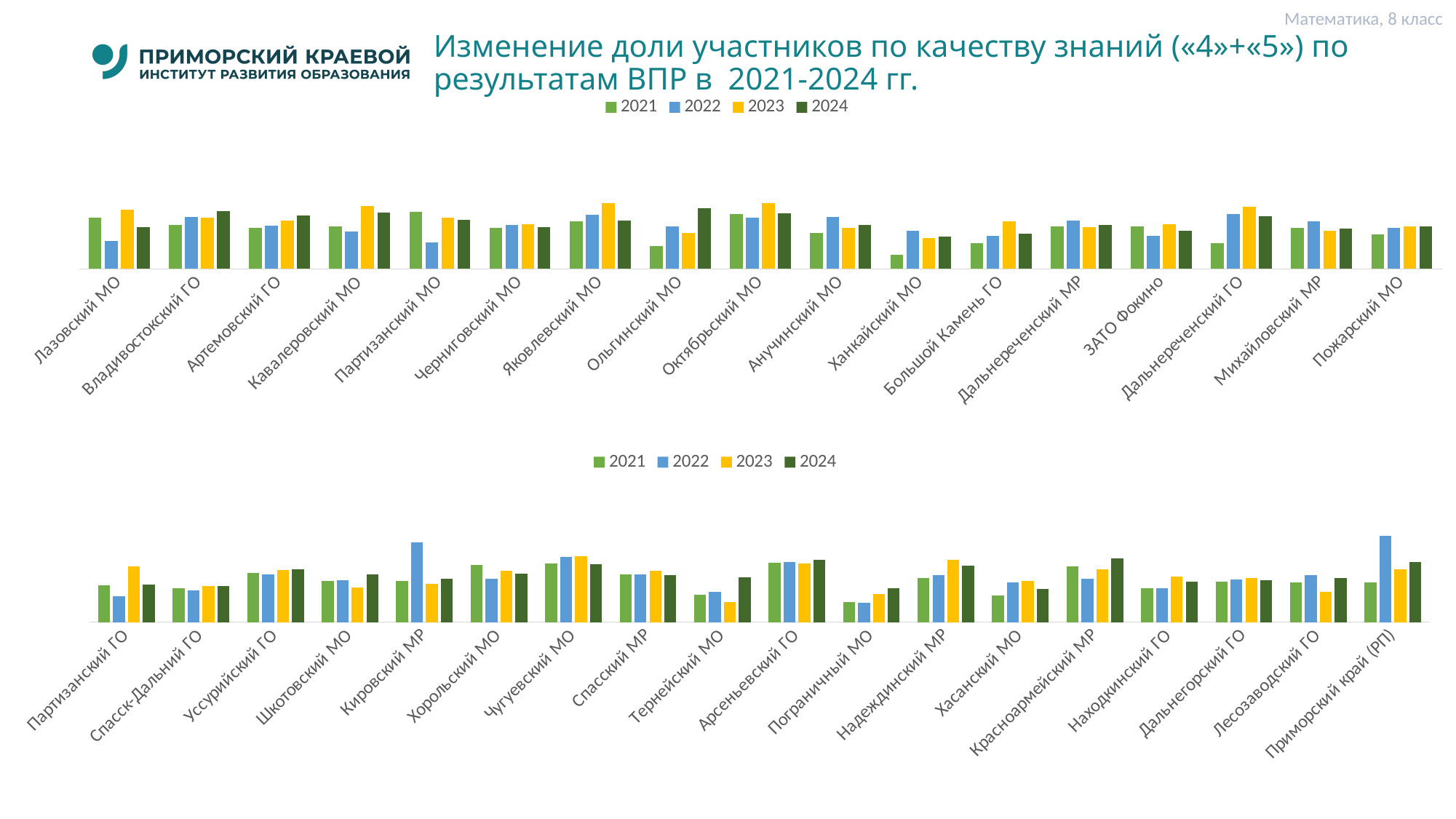
In the bottom chart, which year has the highest value for Кировский МР? 2022 In the top chart, which year has the lowest value for Лазовский МО? 2022 In the bottom chart, which year has the highest value for Приморский край (РП)? 2022 How many categories are shown on the x axis of the top chart? 17 In the top chart, which year has the lowest value for Ханкайский МО? 2021 What kind of chart is the top chart on the slide? bar chart How many series does the legend of the top chart list? 4 In the top chart, is the 2021 value or the 2022 value larger for Партизанский МО? 2021 How many categories are shown on the x axis of the bottom chart? 18 In the bottom chart, is the 2023 value or the 2024 value larger for Пограничный МО? 2024 Which years are listed in the legend of the bottom chart? 2021, 2022, 2023, 2024 In the top chart, which year has the highest value for Ольгинский МО? 2024